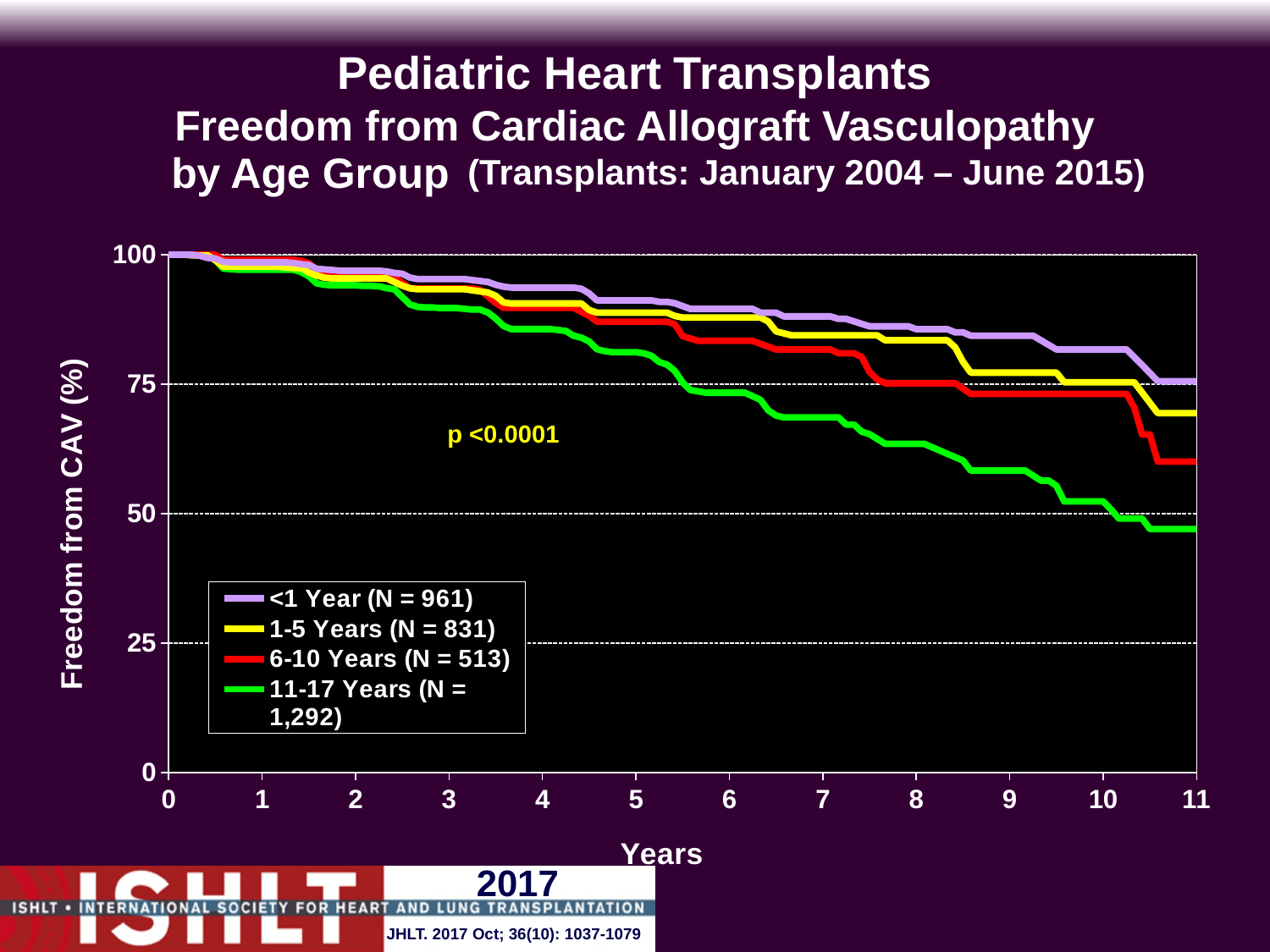
At 8 years, which group has higher freedom from CAV: 6-10 Years or 11-17 Years? 6-10 Years Is the freedom from CAV for the 6-10 Years group at 11 years greater or less than 50? greater Which age group has the highest freedom from CAV at 11 years? <1 Year Do the freedom from CAV values rise or fall as years since transplant increase? fall What is the N for the 6-10 Years group shown in the legend? 513 How many age groups (series) does the legend list? 4 Which age group has the lowest freedom from CAV at 11 years? 11-17 Years What kind of chart is shown on the slide? line chart What p-value is printed on the chart? p <0.0001 Is the freedom from CAV for the 11-17 Years group at 11 years greater or less than 50? less Is the freedom from CAV for the 1-5 Years group at 11 years greater or less than 75? less